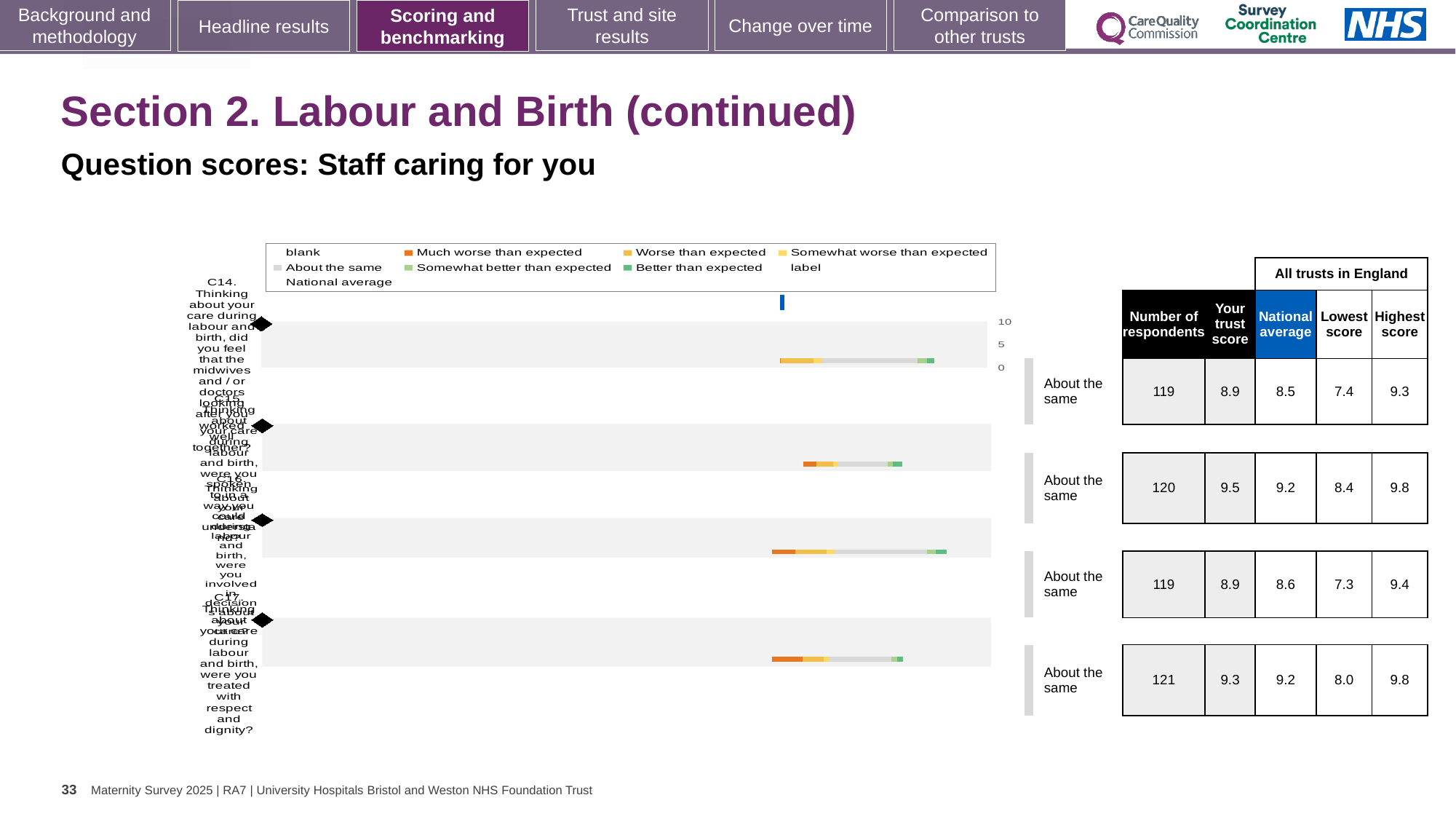
In the table next to the chart, which row has the highest 'Your trust score'? the second row (9.5) What kind of chart is shown on the slide? bar chart In the table next to the chart, what is the difference between 'Your trust score' and the national average for the first row? 0.4 What benchmark label is shown for each of the four question rows? About the same In the table next to the chart, what is the number of respondents for the first row (C14)? 119 In the table next to the chart, what is 'Your trust score' for the second row? 9.5 In the table next to the chart, for the second row, which is larger: 'Your trust score' or the national average? Your trust score In the table next to the chart, what is the national average for the last row (C17)? 9.2 In the chart legend, what colour represents 'Much worse than expected'? orange In the table next to the chart, what is the lowest value in the 'Lowest score' column? 7.3 In the chart legend, what colour represents 'Better than expected'? green How many question rows (categories) are plotted in the chart? 4